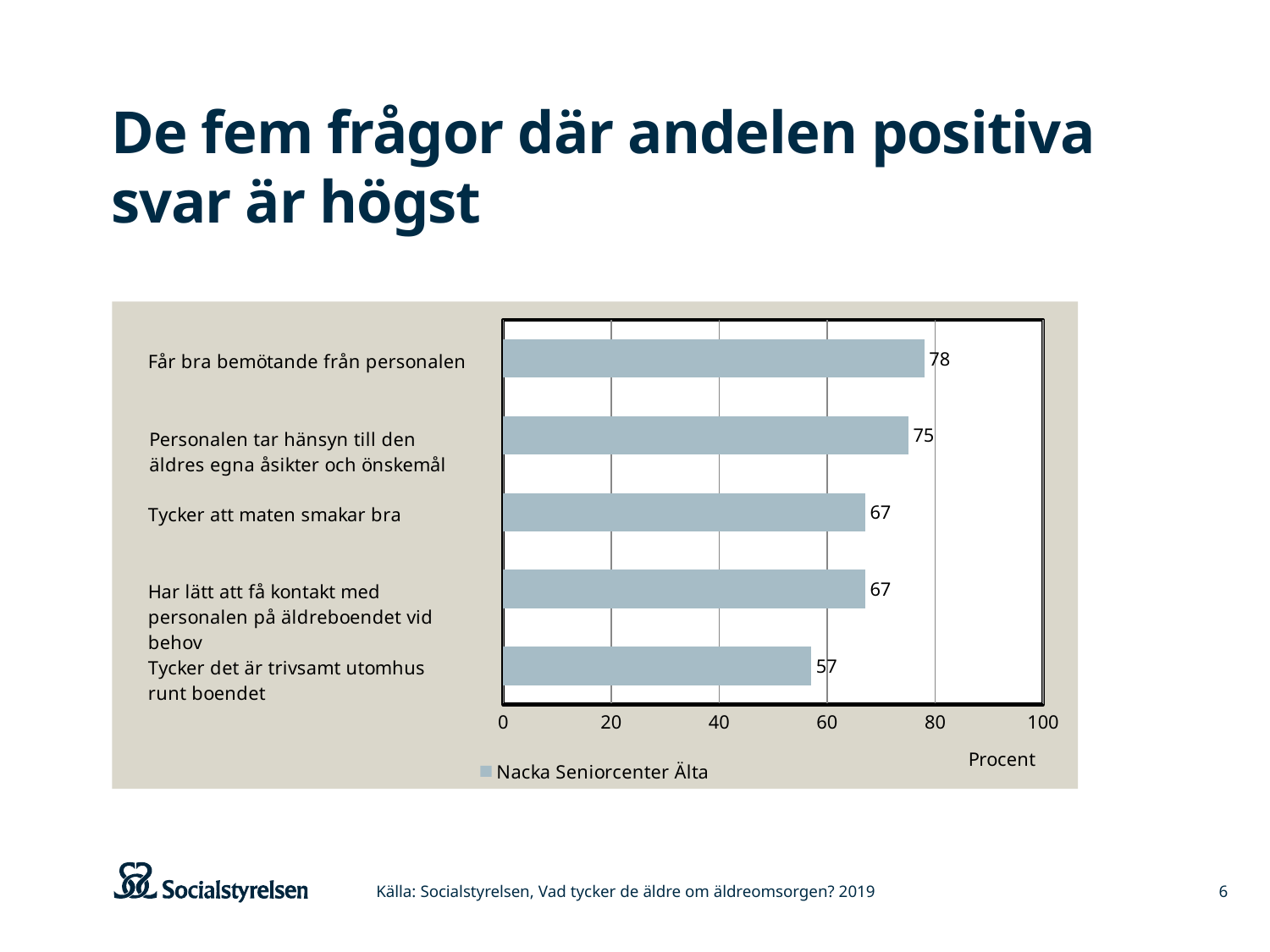
What is the value for "Får bra bemötande från personalen"? 78 Is the value for "Tycker att maten smakar bra" greater or less than 60? greater What kind of chart is shown on the slide? bar chart Which category has the lowest value? Tycker det är trivsamt utomhus runt boendet What series name is shown in the legend? Nacka Seniorcenter Älta What is the difference between the values for "Får bra bemötande från personalen" and "Tycker det är trivsamt utomhus runt boendet"? 21 How many series does the legend list? 1 How many categories are shown in the chart? 5 Which category has the highest value? Får bra bemötande från personalen What is the value for "Personalen tar hänsyn till den äldres egna åsikter och önskemål"? 75 Which is larger: the value for "Personalen tar hänsyn till den äldres egna åsikter och önskemål" or the value for "Tycker att maten smakar bra"? Personalen tar hänsyn till den äldres egna åsikter och önskemål What is the value for "Tycker det är trivsamt utomhus runt boendet"? 57